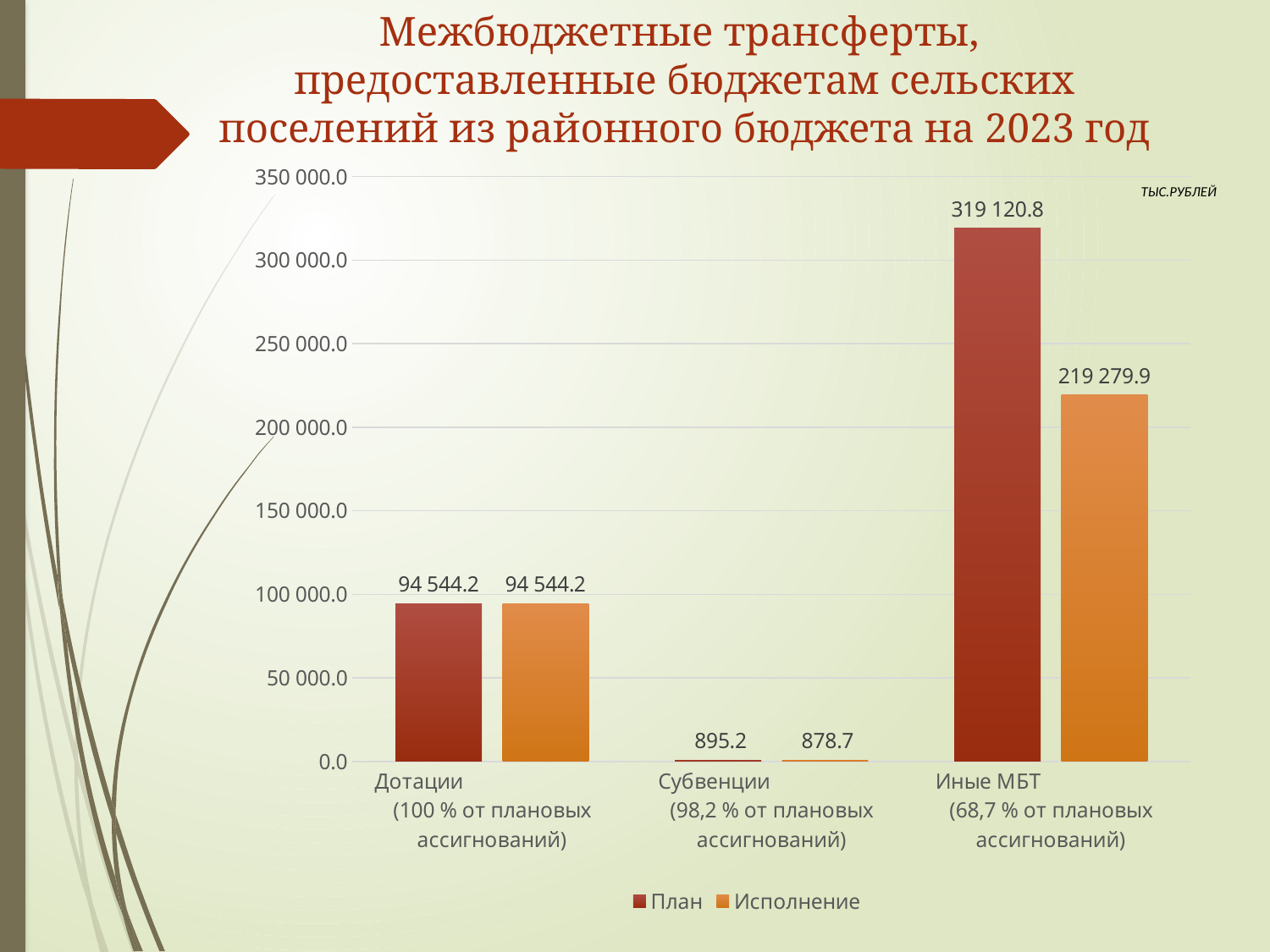
Which category has the highest План value? Иные МБТ What is the Исполнение value for Субвенции? 878.7 What is the Исполнение value for Иные МБТ? 219 279.9 What kind of chart is shown on the slide? Bar chart How many categories are shown on the x axis? 3 How many series does the legend list? 2 Which is larger, the План value for Иные МБТ or the Исполнение value for Иные МБТ? План Which category has the lowest Исполнение value? Субвенции What is the План value for Субвенции? 895.2 What is the План value for Дотации? 94 544.2 What is the difference between the План and Исполнение values for Иные МБТ? 99 840.9 What is the difference between the План and Исполнение values for Субвенции? 16.5